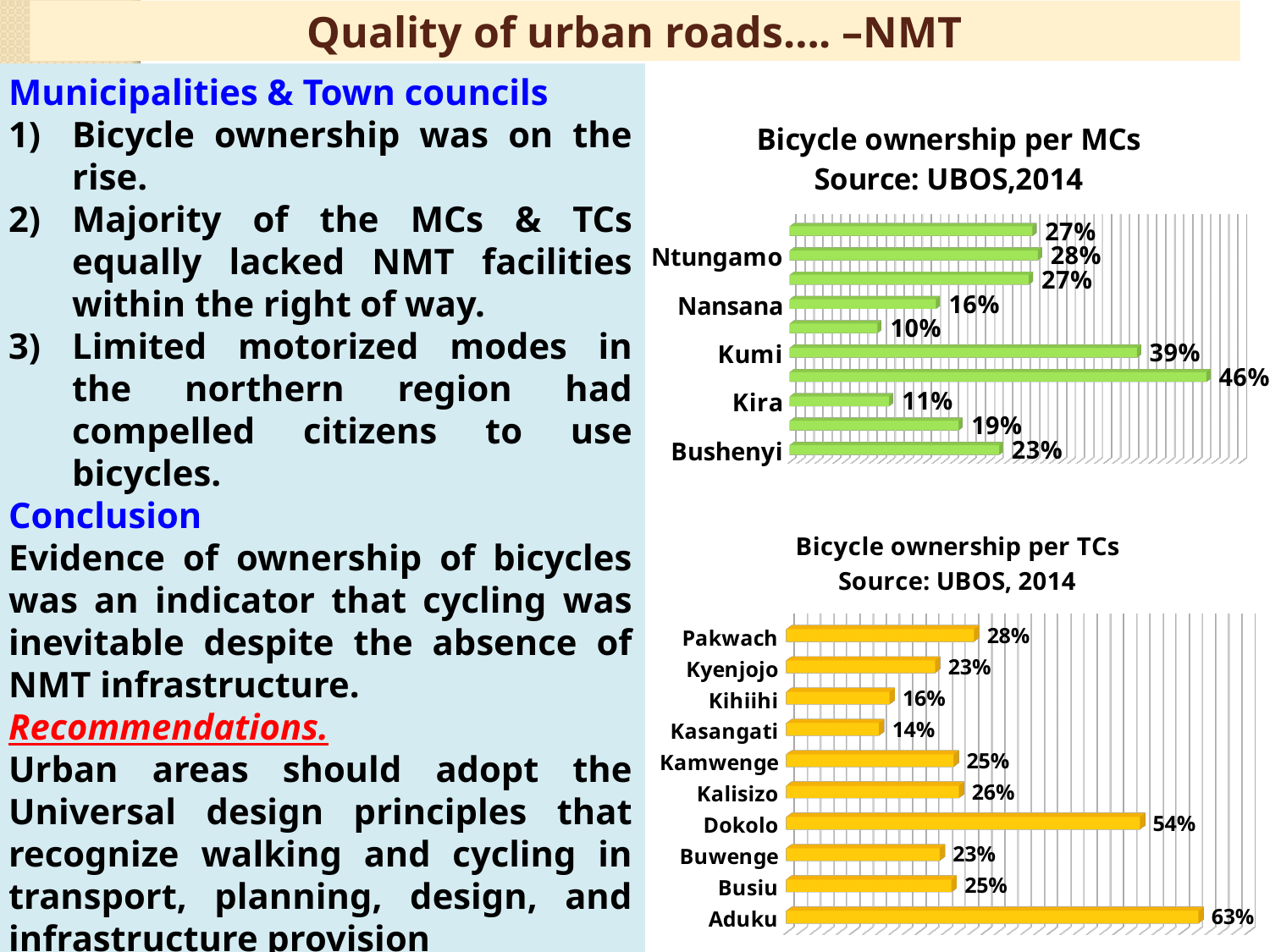
In the 'Bicycle ownership per TCs' chart, which town council has the lowest bicycle ownership? Kasangati In the 'Bicycle ownership per TCs' chart, which is larger, Kalisizo or Kamwenge? Kalisizo In the 'Bicycle ownership per TCs' chart, how many town councils are shown? 10 In the 'Bicycle ownership per MCs' chart, what is the value for Kumi? 39% What type of chart is the 'Bicycle ownership per MCs' chart? Bar chart In the 'Bicycle ownership per TCs' chart, what is the difference between Aduku and Dokolo? 9% In the 'Bicycle ownership per TCs' chart, which town council has the highest bicycle ownership? Aduku In the 'Bicycle ownership per TCs' chart, what is the value for Aduku? 63% In the 'Bicycle ownership per MCs' chart, what is the highest value shown on any bar? 46% In the 'Bicycle ownership per TCs' chart, what is the value for Dokolo? 54% In the 'Bicycle ownership per MCs' chart, what is the difference between Bushenyi and Nansana? 7% In the 'Bicycle ownership per MCs' chart, what is the value for Kira? 11%